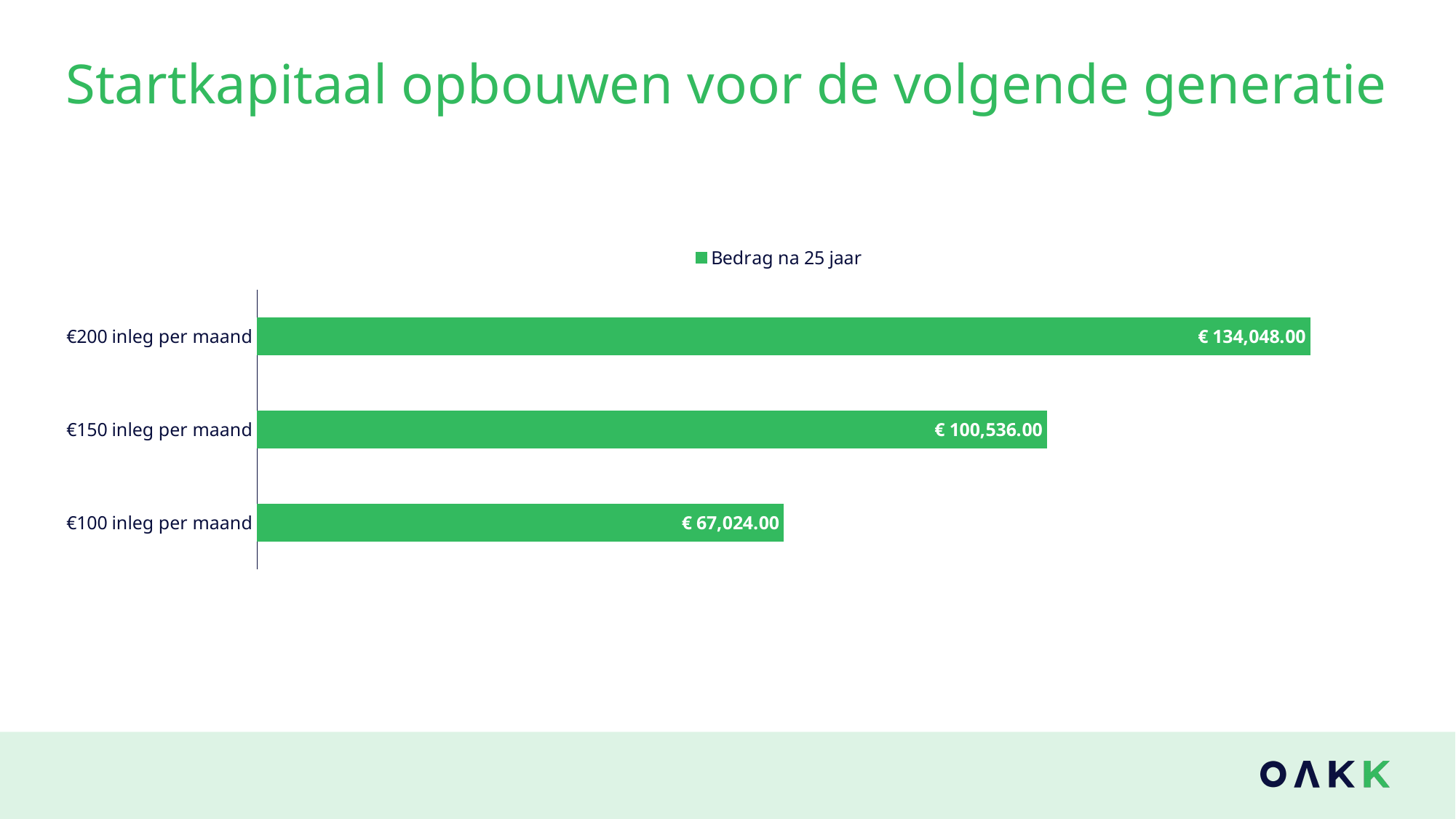
What kind of chart is shown on the slide? Bar chart How many series does the legend list? 1 What is the value for €150 inleg per maand? € 100,536.00 What is the difference between the values for €200 inleg per maand and €100 inleg per maand? € 67,024.00 What is the difference between the values for €150 inleg per maand and €100 inleg per maand? € 33,512.00 How many categories are shown in the chart? 3 What is the legend entry of the series shown in the chart? Bedrag na 25 jaar What is the value for €200 inleg per maand? € 134,048.00 Which category has the highest value? €200 inleg per maand What is the value for €100 inleg per maand? € 67,024.00 Which category has the lowest value? €100 inleg per maand Which is larger, the value for €150 inleg per maand or €100 inleg per maand? €150 inleg per maand